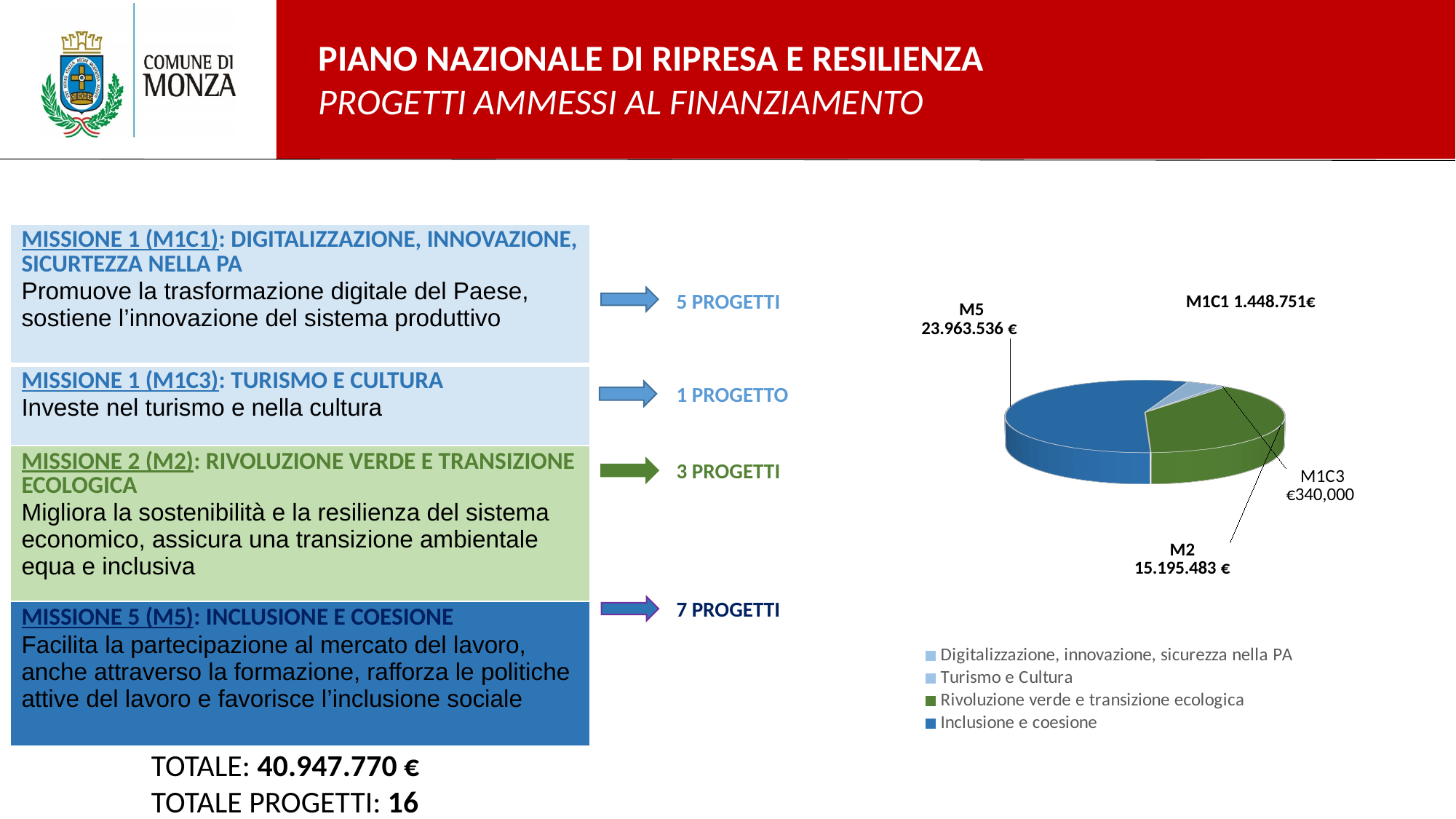
What is the difference between the M5 and M2 values in the pie chart? 8.768.053 € What kind of chart is shown on the right side of the slide? Pie chart How many slices does the pie chart have? 4 What is the value shown for M2 in the pie chart? 15.195.483 € In the pie chart, which is larger: M2 or M1C1? M2 Which legend entry of the pie chart corresponds to the green slice? Rivoluzione verde e transizione ecologica Which slice of the pie chart has the smallest value? M1C3 What is the value shown for M5 in the pie chart? 23.963.536 € What is the value shown for M1C1 in the pie chart? 1.448.751€ What is the value shown for M1C3 in the pie chart? €340,000 Which slice of the pie chart has the largest value? M5 How many entries does the pie chart's legend list? 4